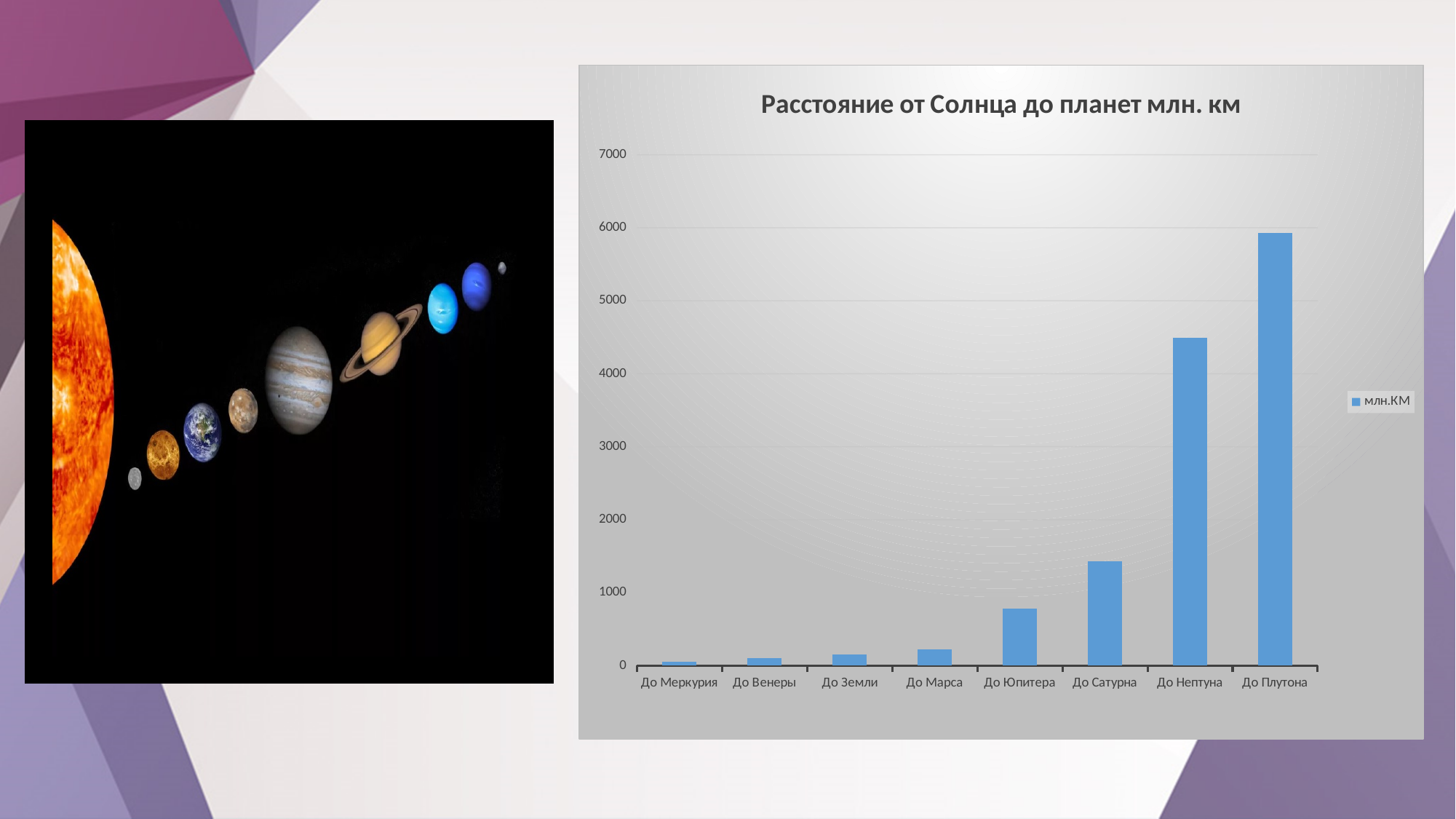
Which is larger, the value for До Нептуна or the value for До Сатурна? До Нептуна Which category has the lowest value in the chart? До Меркурия What type of chart is shown on the slide? bar chart Is the value for До Юпитера greater or less than 1000? less What is the title of the chart? Расстояние от Солнца до планет млн. км Which category has the highest value in the chart? До Плутона How many series does the chart legend list? 1 How many categories (planets) are shown on the x axis of the chart? 8 Do the values rise or fall moving from left to right along the x axis? rise What is the name of the series shown in the legend? млн.КМ Is the value for До Нептуна greater or less than 4000? greater Is the value for До Плутона greater or less than 5000? greater